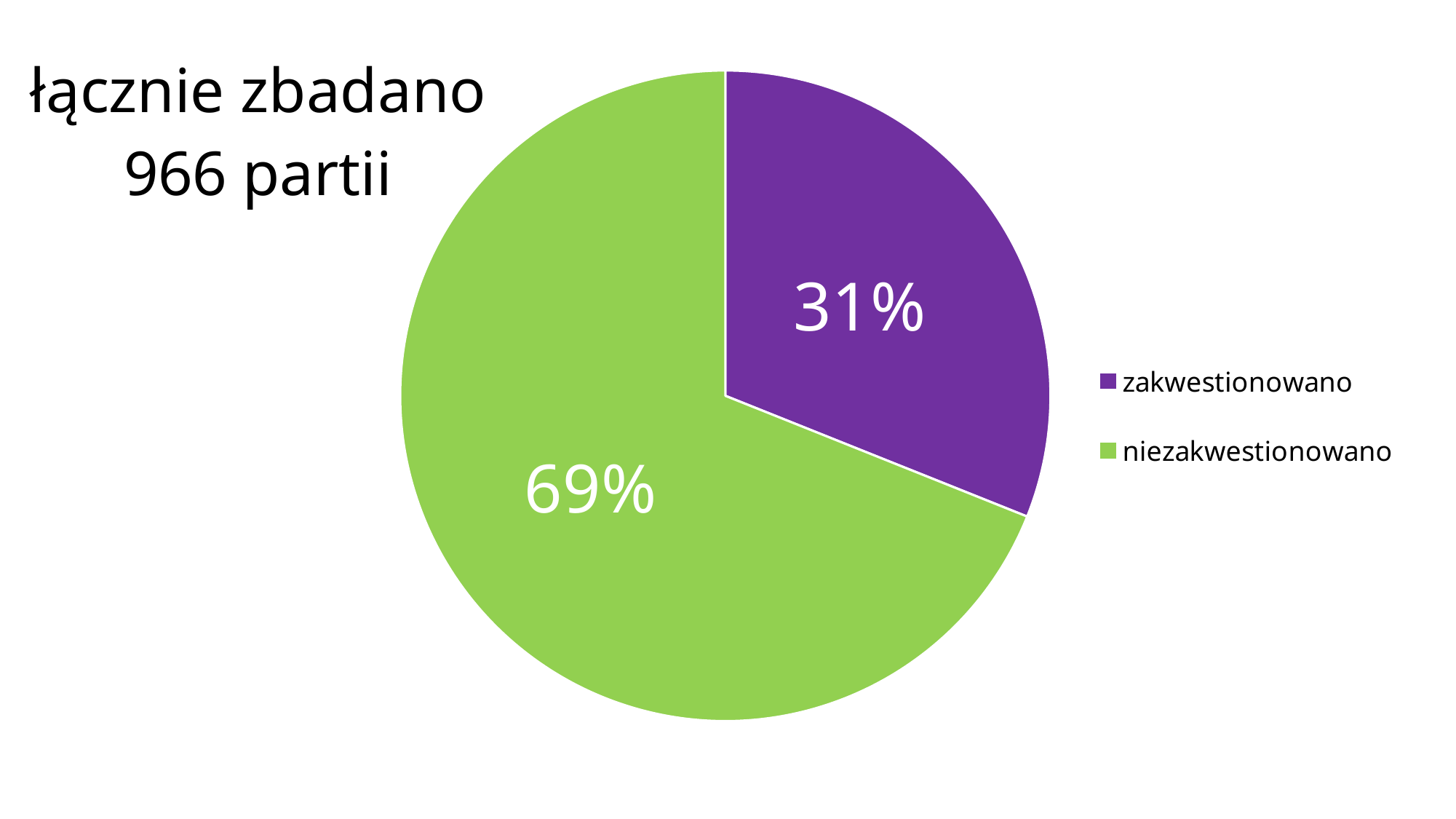
What share of the pie is labelled "zakwestionowano"? 31% According to the text on the slide, how many batches (partii) were examined in total? 966 What share of the pie is labelled "niezakwestionowano"? 69% Which slice is the largest? niezakwestionowano Which slice is the smallest? zakwestionowano What colour is the "zakwestionowano" slice? purple How many entries does the legend list? 2 What is the difference in percentage points between the "niezakwestionowano" and "zakwestionowano" slices? 38 What kind of chart is shown on the slide? pie chart Which is larger, the "zakwestionowano" slice or the "niezakwestionowano" slice? niezakwestionowano How many slices does the pie chart have? 2